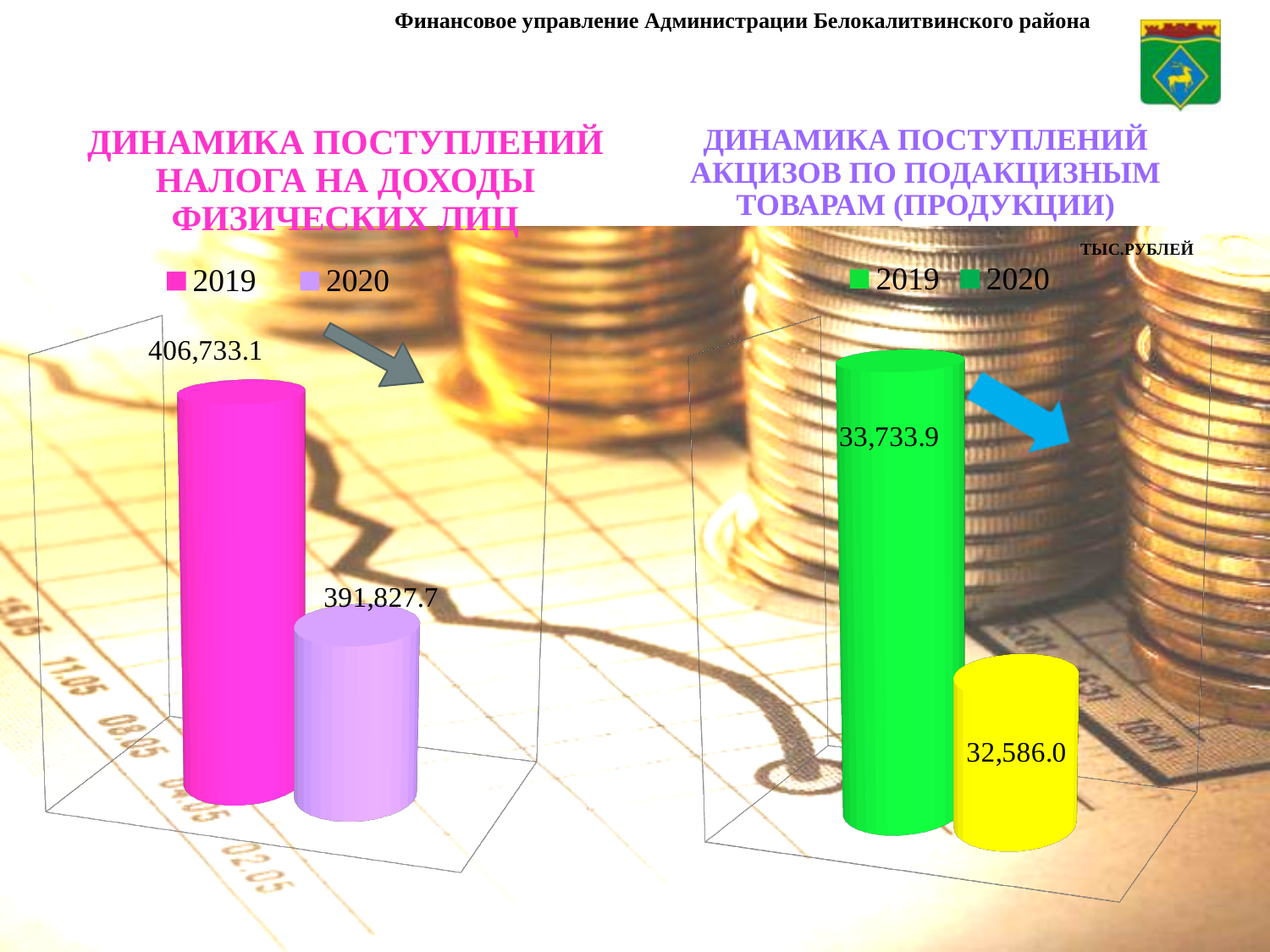
In the left chart (НДФЛ), which year has the higher value? 2019 How many series does the legend of the left chart (НДФЛ) list? 2 In the right chart (акцизы), is the value for 2019 larger or smaller than the value for 2020? larger In the right chart (акцизы), what is the difference between the 2019 and 2020 values? 1,147.9 In the left chart (НДФЛ), what is the value for 2020? 391,827.7 In the right chart (акцизы), which year has the lower value? 2020 In the left chart (НДФЛ), do the values rise or fall from 2019 to 2020? fall In the left chart (НДФЛ), what is the difference between the 2019 and 2020 values? 14,905.4 In the right chart (акцизы), what is the value for 2019? 33,733.9 In the right chart (акцизы), what is the value for 2020? 32,586.0 In the left chart (НДФЛ), what is the value for 2019? 406,733.1 What kind of chart is the right chart (акцизы)? bar chart